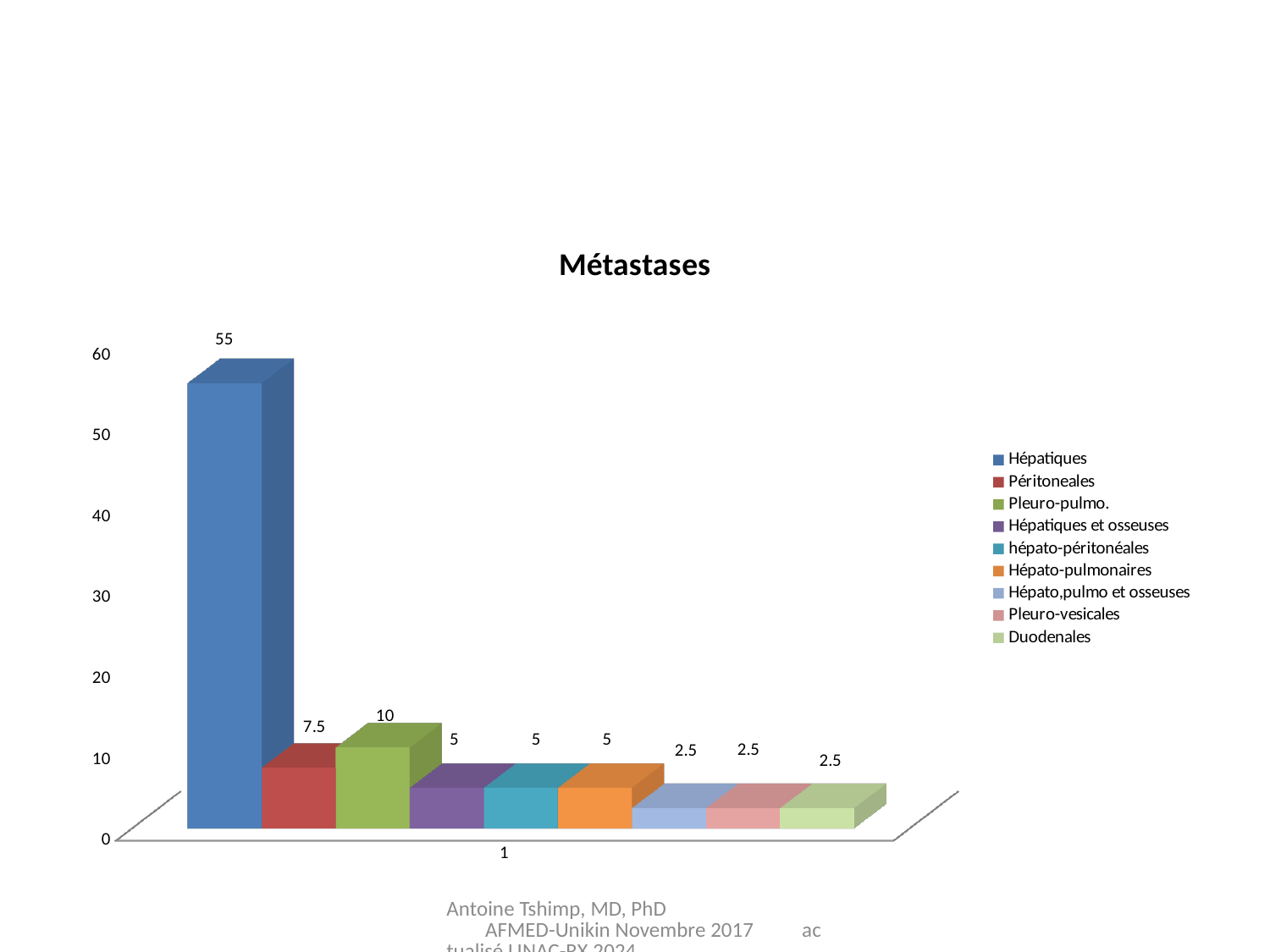
What is the value for Duodenales in the Métastases chart? 2.5 How many series does the legend list in the Métastases chart? 9 Which series has the highest value in the Métastases chart? Hépatiques What is the value for Péritoneales in the Métastases chart? 7.5 What is the value for Hépatiques in the Métastases chart? 55 What is the title of the chart on the slide? Métastases What is the difference between the values for Pleuro-pulmo. and Péritoneales? 2.5 What is the difference between the values for Hépatiques and Pleuro-pulmo.? 45 What is the value for Pleuro-pulmo. in the Métastases chart? 10 Which is larger, the value for Péritoneales or the value for Hépato-pulmonaires? Péritoneales Is the value for Hépatiques greater or less than 50? greater What kind of chart is shown on the slide? bar chart